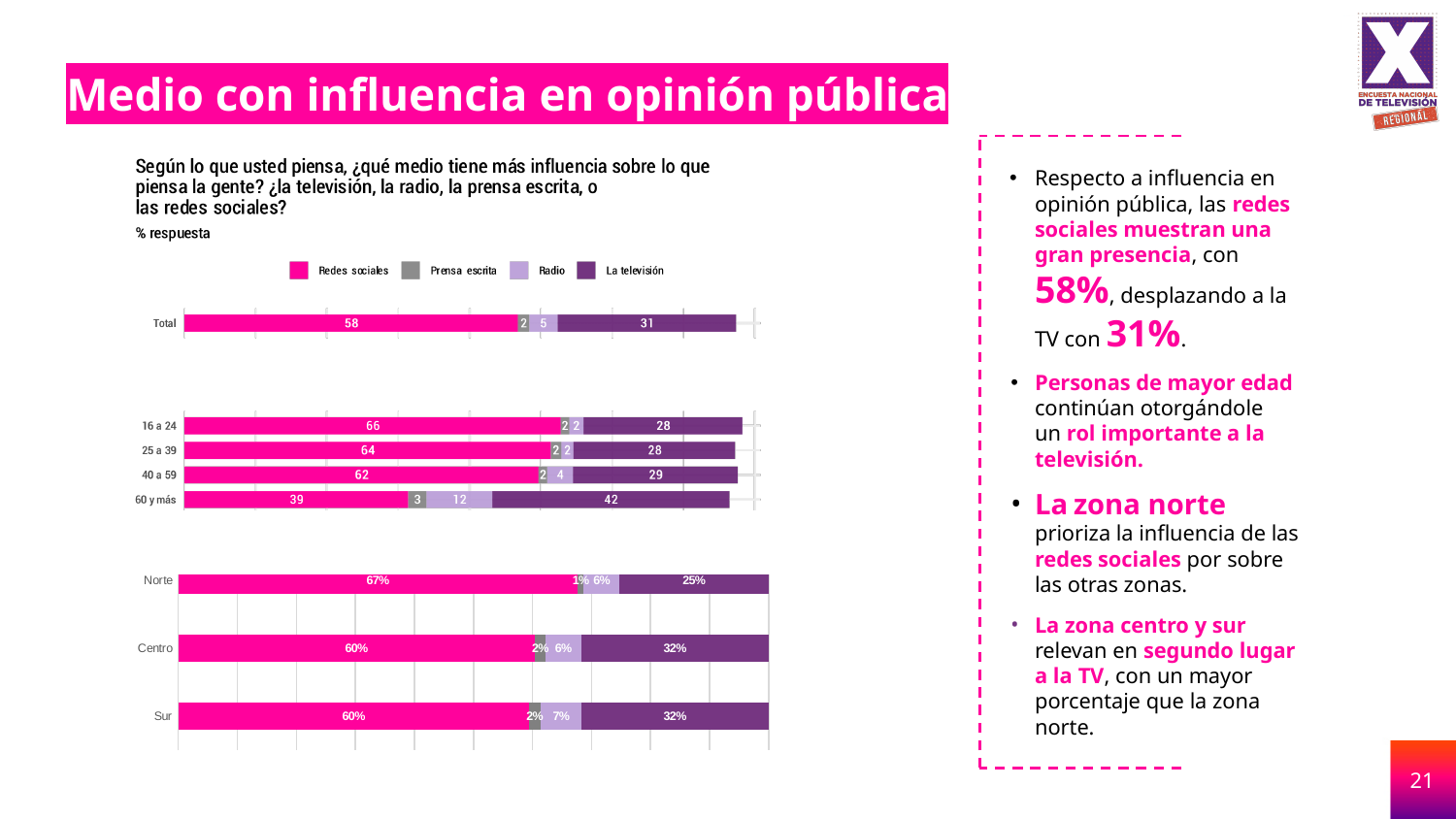
In the bottom chart (zones), what is the La televisión value for Sur? 32% In the bottom chart (zones), which is larger: the Radio value for Sur or the Radio value for Centro? Sur In the bottom chart (zones), what is the Redes sociales value for Norte? 67% What kind of chart is used on this slide? Stacked bar chart In the middle chart (age groups), what is the difference between the Redes sociales values for 16 a 24 and 60 y más? 27 In the middle chart (age groups), which age group has the lowest value for Redes sociales? 60 y más In the top chart (Total), what is the value for Redes sociales? 58 In the middle chart (age groups), what is the Redes sociales value for 60 y más? 39 How many series does the legend list? 4 In the middle chart (age groups), which age group has the highest value for La televisión? 60 y más In the top chart (Total), what is the value for La televisión? 31 In the bottom chart (zones), which zone has the lowest value for La televisión? Norte